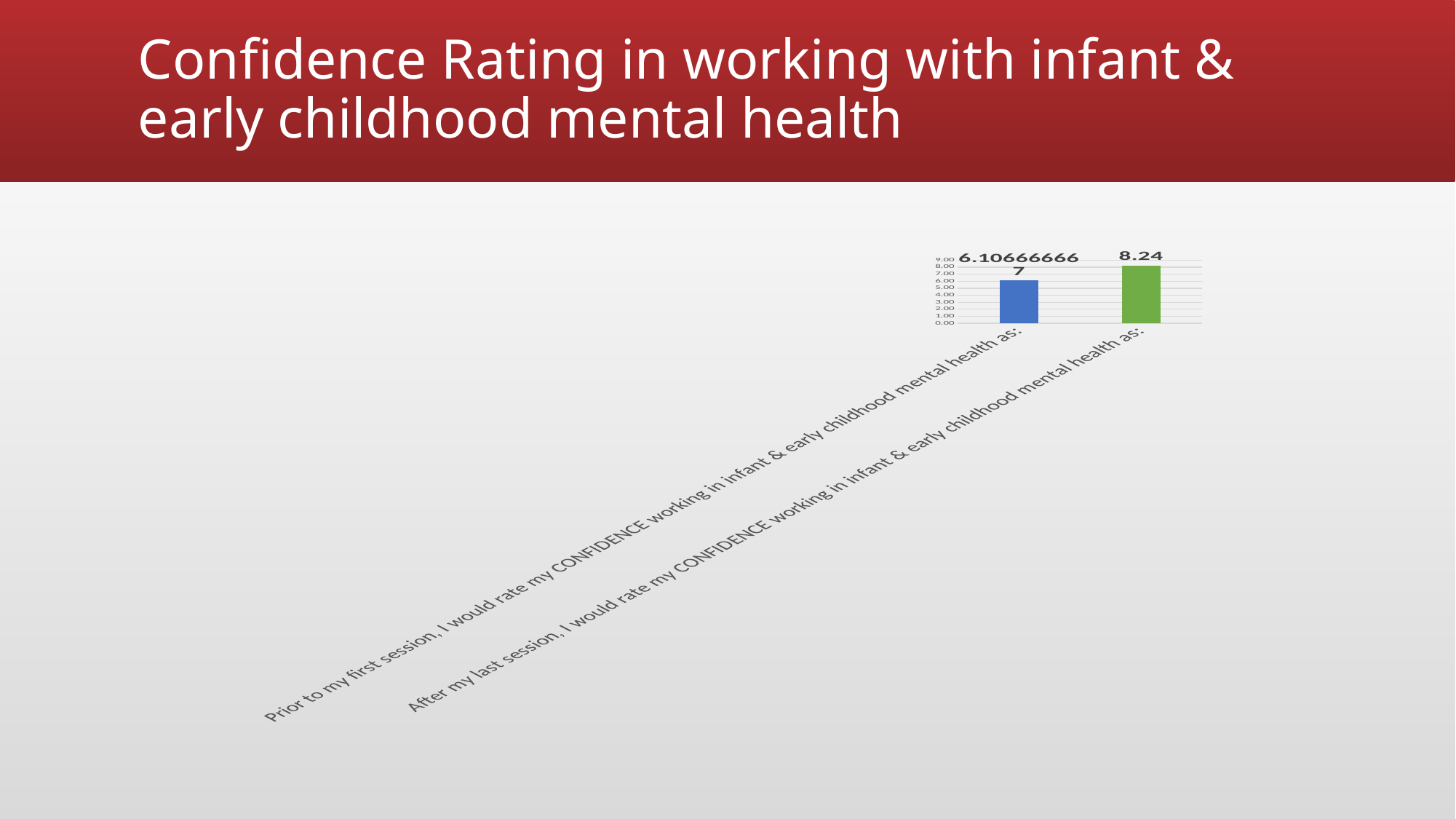
Which is larger, the confidence rating prior to the first session or after the last session? After the last session How many categories are plotted in the chart? 2 Is the value for the "After my last session" bar greater or less than 7.00? greater Is the value for the "Prior to my first session" bar greater or less than 5.00? greater What is the value for "Prior to my first session, I would rate my CONFIDENCE working in infant & early childhood mental health as:"? 6.106666667 What is the highest value shown on the vertical axis? 9.00 What type of chart is shown on the slide? Bar chart Which category has the lowest value? Prior to my first session, I would rate my CONFIDENCE working in infant & early childhood mental health as: What is the value for "After my last session, I would rate my CONFIDENCE working in infant & early childhood mental health as:"? 8.24 Which category has the highest value? After my last session, I would rate my CONFIDENCE working in infant & early childhood mental health as: Do the values rise or fall from the first category to the second along the x axis? Rise What colour is the bar for "After my last session"? Green